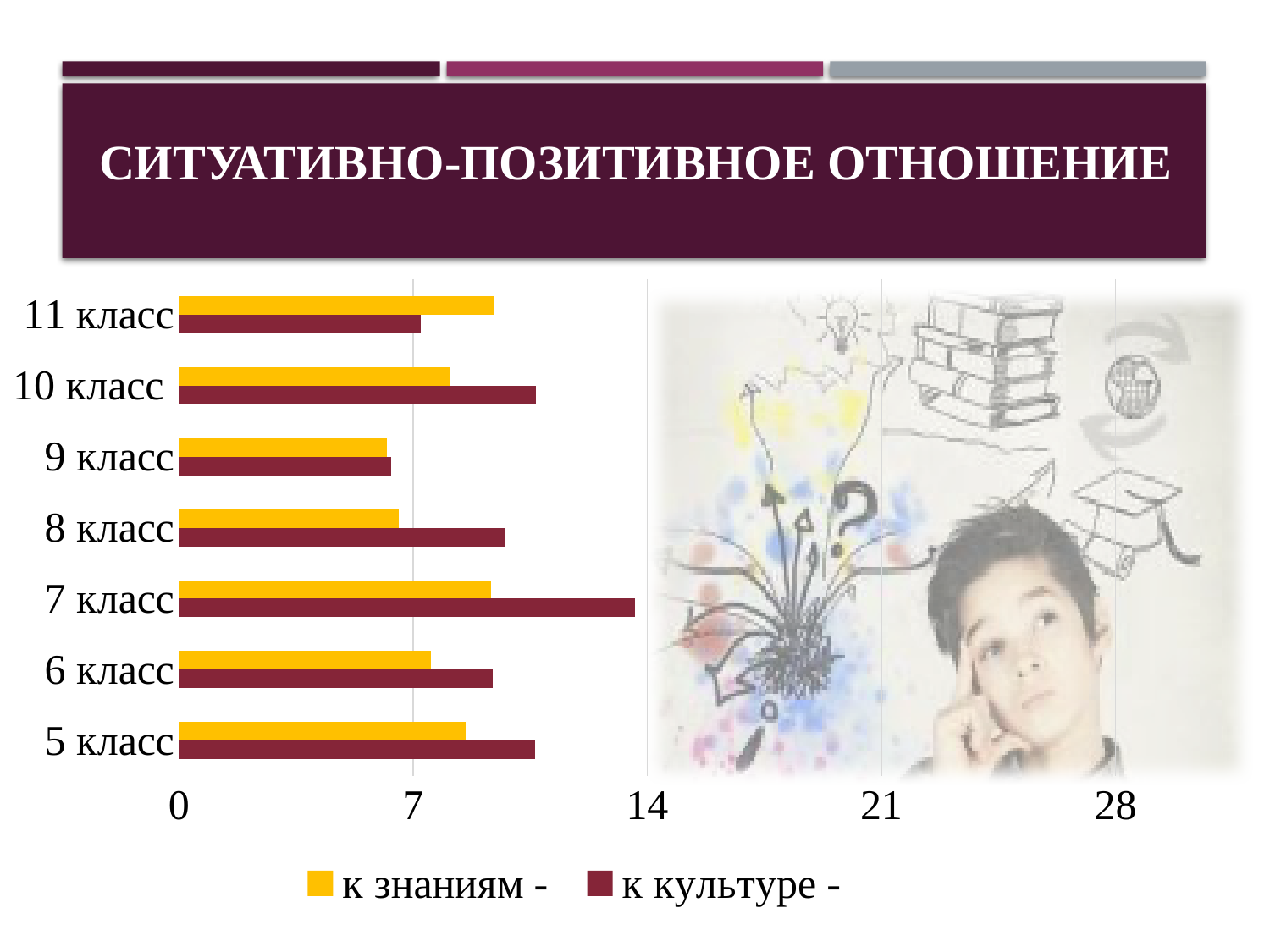
How many classes (categories) are shown on the chart? 7 Which class has the highest value for the series "к культуре -"? 7 класс How many series does the chart legend list? 2 Is the value for "к культуре -" in 7 класс greater or less than 7? greater What kind of chart is shown on the slide? bar chart For 7 класс, which series has the larger value: "к знаниям -" or "к культуре -"? к культуре - Which colour represents the series "к знаниям -" in the chart? yellow Which class has the lowest value for the series "к культуре -"? 9 класс Is the value for "к культуре -" in 10 класс greater or less than 14? less For 11 класс, which series has the larger value: "к знаниям -" or "к культуре -"? к знаниям - What is the title of the slide containing the chart? СИТУАТИВНО-ПОЗИТИВНОЕ ОТНОШЕНИЕ Is the value for "к знаниям -" in 9 класс greater or less than 7? less